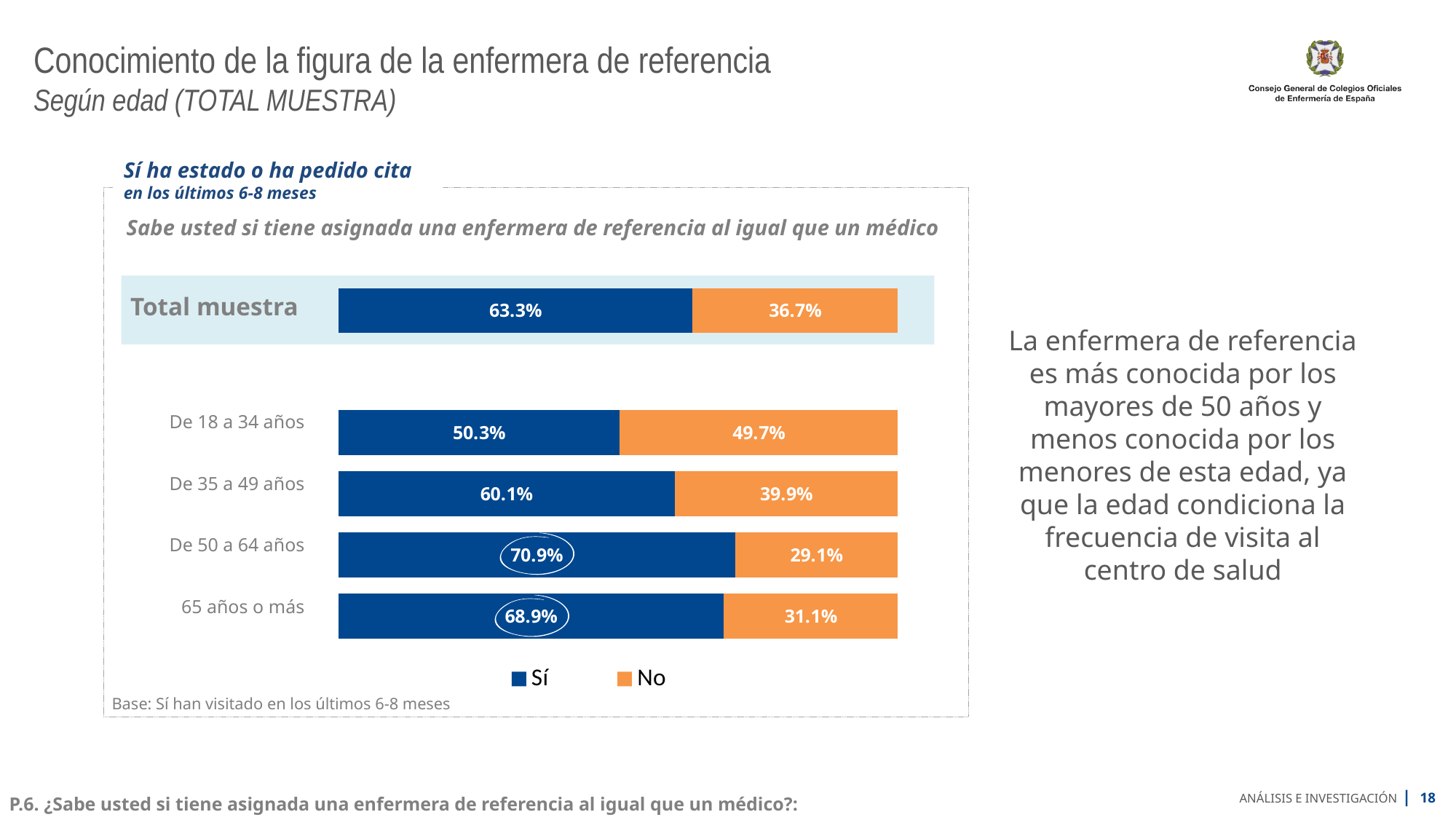
What is the 'No' value for 'De 50 a 64 años'? 29.1% How many age groups are shown in the chart, excluding 'Total muestra'? 4 Which is larger: the 'No' value for 'De 35 a 49 años' or the 'No' value for '65 años o más'? De 35 a 49 años What is the 'No' value for '65 años o más'? 31.1% What is the difference between the 'Sí' values for 'De 50 a 64 años' and 'De 18 a 34 años'? 20.6 percentage points What is the total of the stacked bar for 'De 35 a 49 años'? 100% Which age group has the lowest 'Sí' value? De 18 a 34 años What kind of chart is shown on the slide? Stacked bar chart How many series does the legend list? 2 What is the 'Sí' value for 'De 18 a 34 años'? 50.3% What is the 'Sí' value for 'Total muestra'? 63.3% Which age group has the highest 'Sí' value? De 50 a 64 años